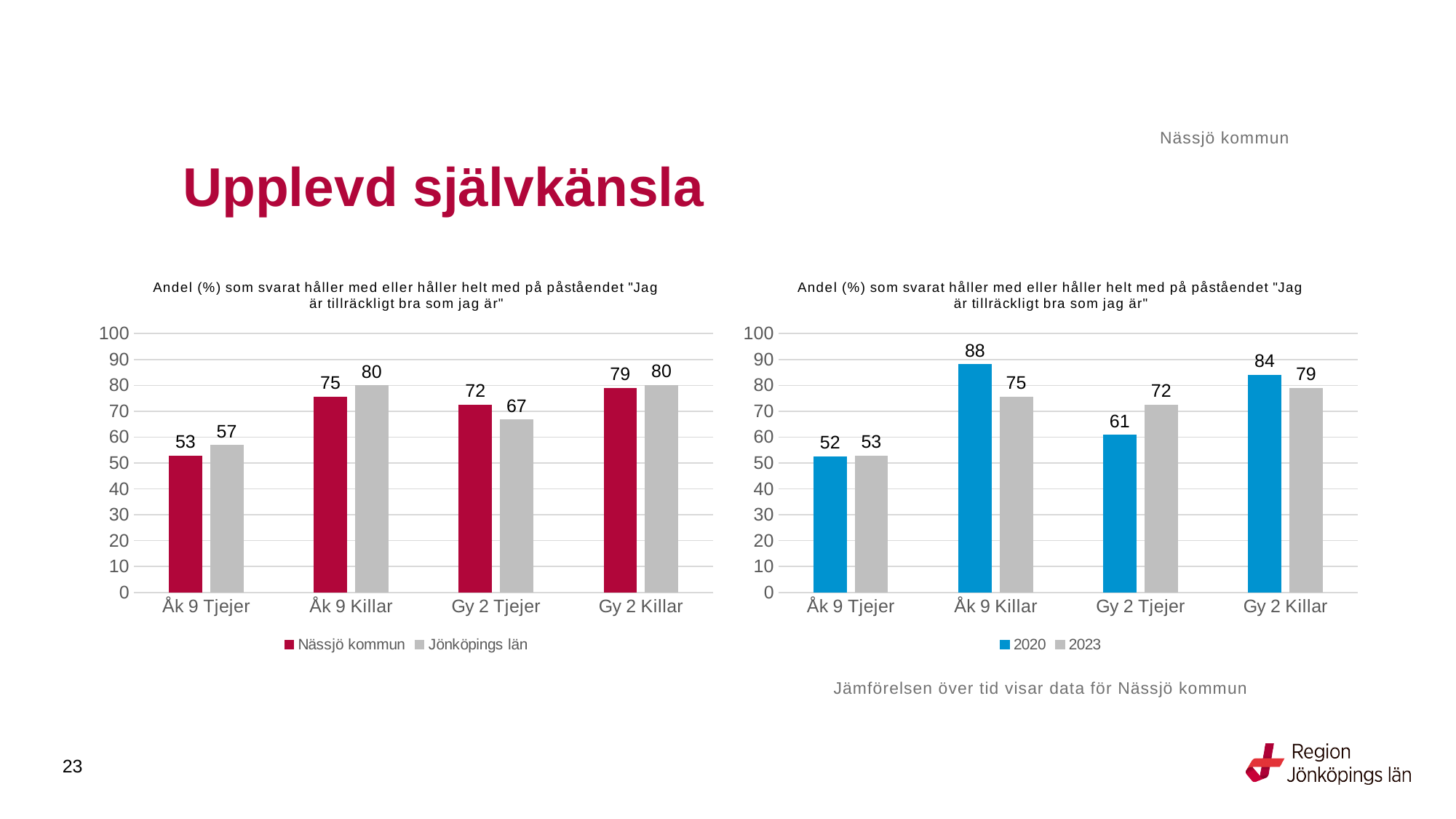
In the left chart, what is the difference between Jönköpings län and Nässjö kommun for Åk 9 Killar? 5 In the right chart, how many series does the legend list? 2 In the right chart, which category has the lowest 2020 value? Åk 9 Tjejer In the left chart, which category has the highest value for Nässjö kommun? Gy 2 Killar What type of chart is the right chart? Bar chart In the right chart, what is the difference between the 2020 and 2023 values for Åk 9 Killar? 13 In the left chart, what is the value for Jönköpings län for Gy 2 Tjejer? 67 How many categories are shown on the x axis of the left chart? 4 In the left chart, which is larger for Gy 2 Tjejer: Nässjö kommun or Jönköpings län? Nässjö kommun In the right chart, what is the 2020 value for Åk 9 Killar? 88 In the left chart, what is the value for Nässjö kommun for Åk 9 Tjejer? 53 In the right chart, what is the 2023 value for Gy 2 Tjejer? 72